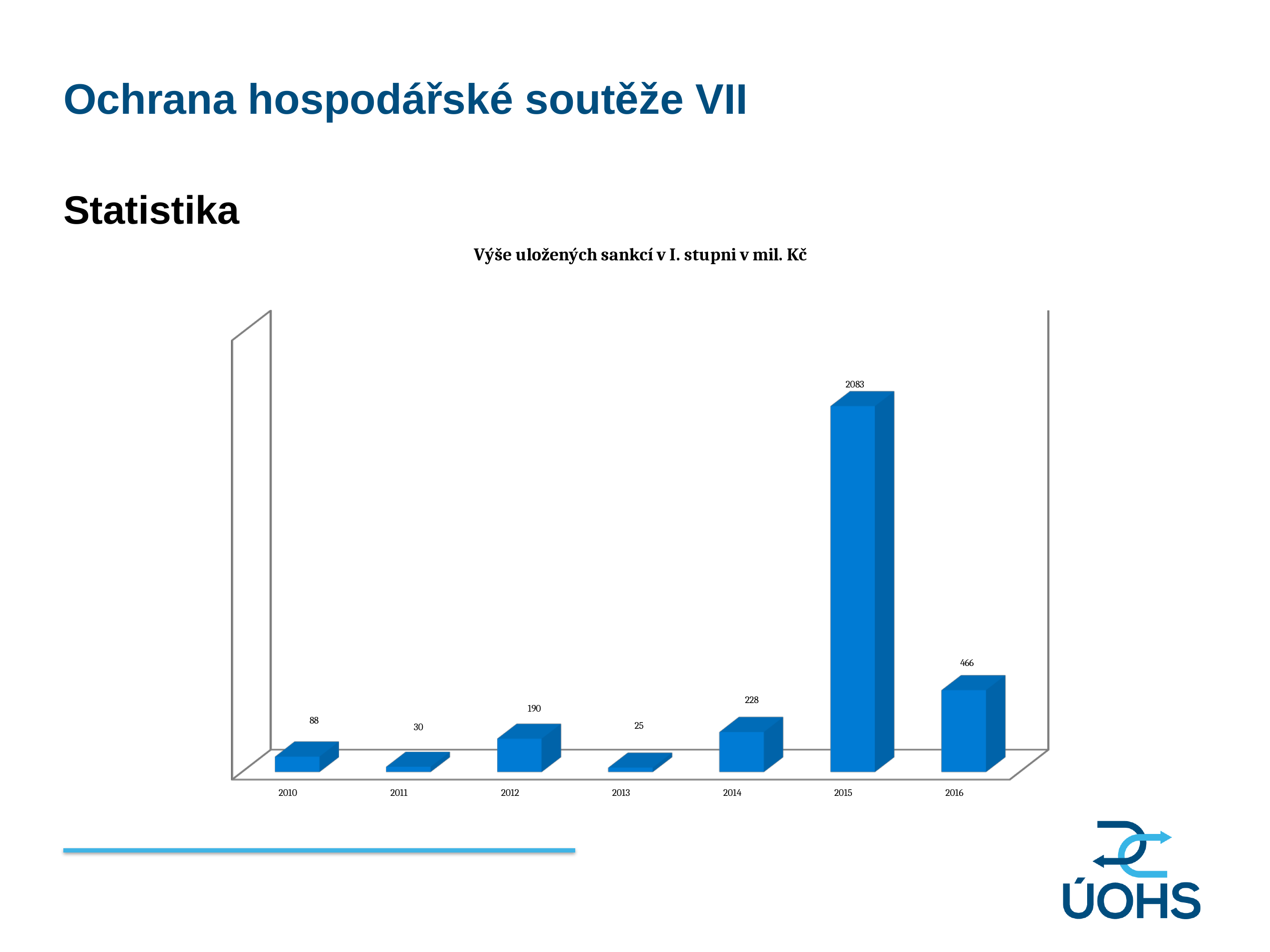
What is the title of the chart? Výše uložených sankcí v I. stupni v mil. Kč What is the difference between the values for 2014 and 2012? 38 What is the value for 2016? 466 Does the value rise or fall from 2015 to 2016? Fall Which year has the lowest value? 2013 What is the difference between the values for 2015 and 2016? 1617 What is the value for 2013? 25 How many years are shown on the x axis? 7 Which year has the highest value? 2015 What kind of chart is shown on the slide? Bar chart What is the value for 2015? 2083 Which is larger, the value for 2010 or the value for 2011? 2010